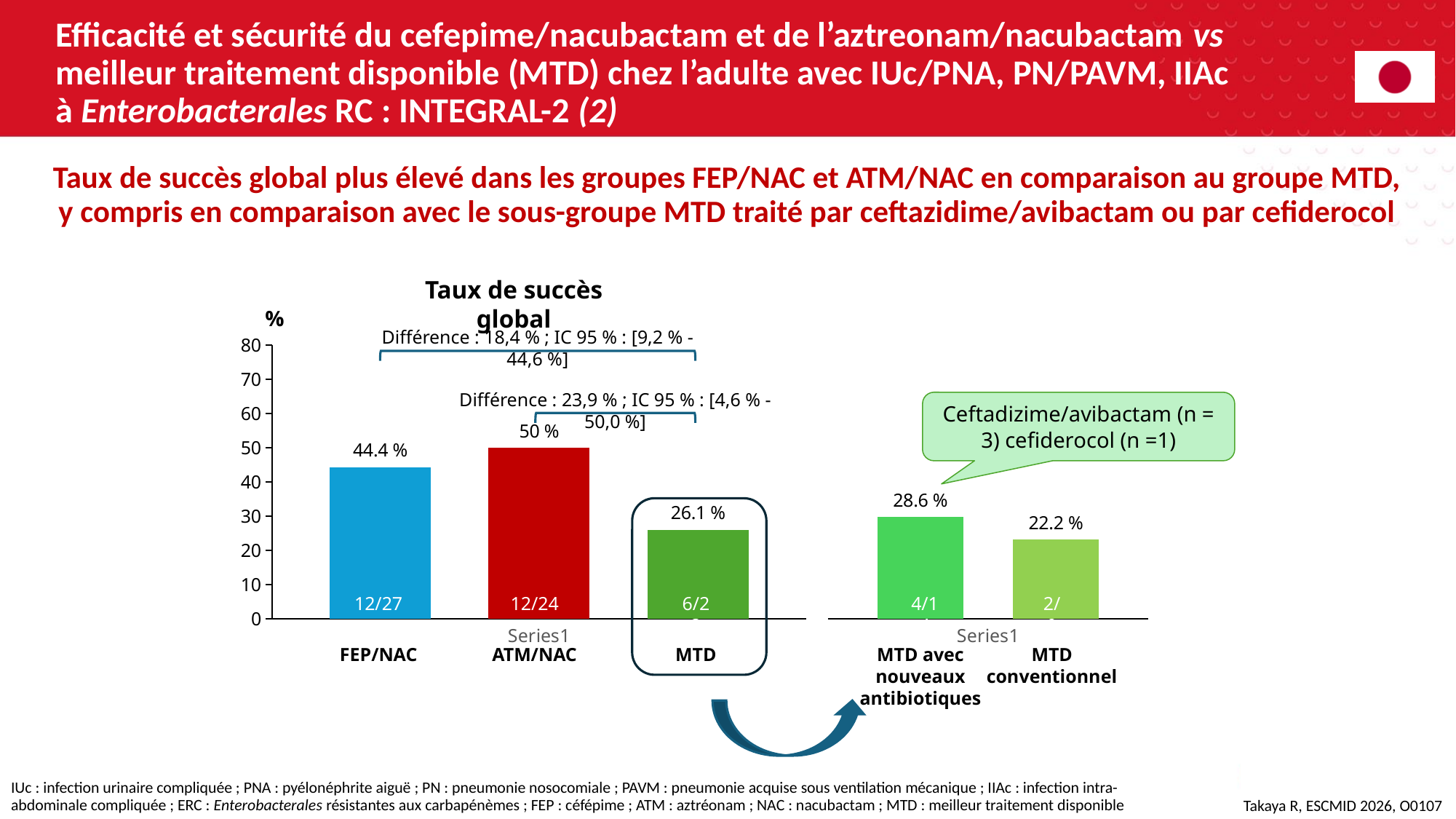
Which group has the highest success rate in the chart? ATM/NAC What is the success rate shown for the 'MTD conventionnel' group? 22.2 % Which has a higher success rate, FEP/NAC or MTD? FEP/NAC What type of chart is used to show the success rates? Bar chart What is the success rate shown for the FEP/NAC group in the 'Taux de succès global' chart? 44.4 % What is the success rate shown for the MTD group? 26.1 % What is the success rate shown for the ATM/NAC group? 50 % What is the difference in success rate between ATM/NAC and FEP/NAC? 5.6 % Which group has the lowest success rate in the chart? MTD conventionnel How many bars are plotted in the chart? 5 What is the success rate shown for the 'MTD avec nouveaux antibiotiques' group? 28.6 % Is the success rate for the MTD group greater or less than 30? less